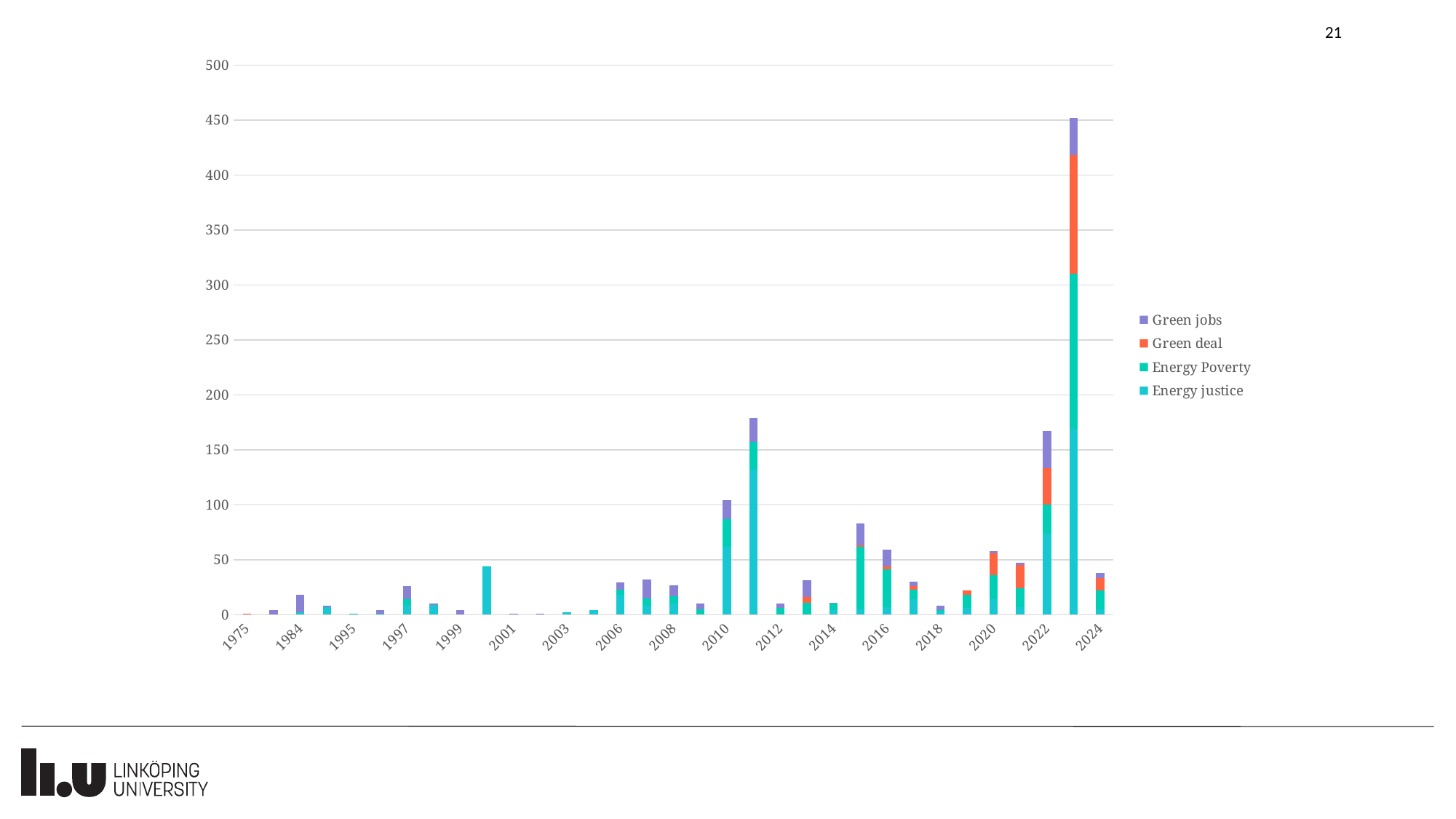
Is the tallest bar on the chart greater or less than 400? greater Is the total value for 2024 greater or less than 50? less Is the total value for 2014 greater or less than 50? less Which has the larger total, 2022 or 2024? 2022 What kind of chart is shown on the slide? stacked bar chart Which has the larger total, 2010 or 2012? 2010 Which series are listed in the legend? Green jobs, Green deal, Energy Poverty, Energy justice How many series does the legend list? 4 How many year labels are shown on the x axis? 17 Do the bar totals generally rise or fall from 1975 to 2024? rise